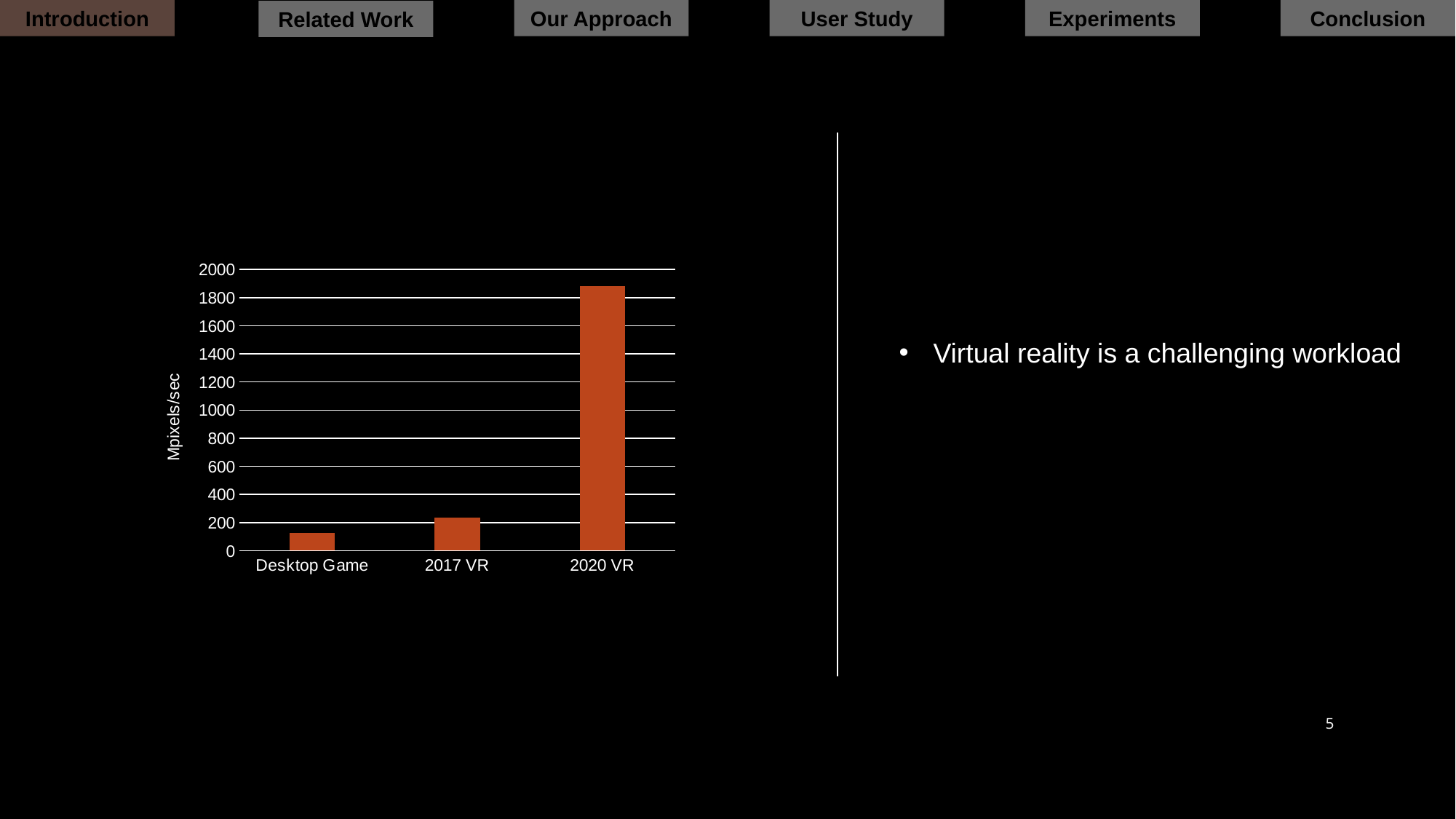
Which is larger, the value for 2020 VR or the value for 2017 VR? 2020 VR Do the values rise or fall from Desktop Game to 2020 VR along the x axis? rise What kind of chart is shown on the slide? bar chart Is the value for Desktop Game greater or less than 200? less Is the value for 2017 VR greater or less than 400? less Which category has the lowest value in the chart? Desktop Game How many categories are plotted on the x axis of the chart? 3 What is the label on the y axis of the chart? Mpixels/sec Which is larger, the value for 2017 VR or the value for Desktop Game? 2017 VR Which category has the highest value in the chart? 2020 VR Is the value for 2020 VR greater or less than 1800? greater